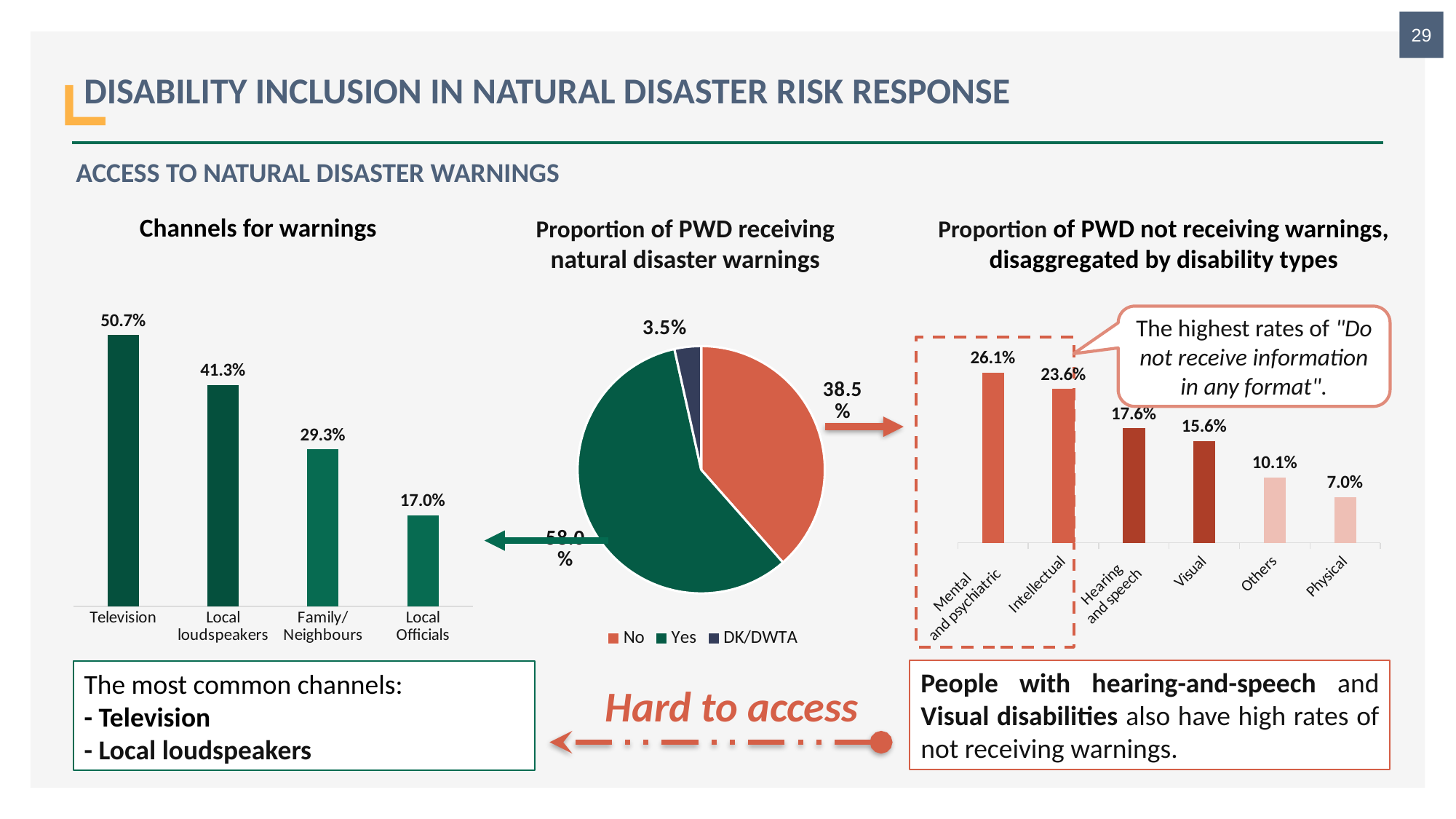
In the 'Proportion of PWD receiving natural disaster warnings' pie chart, what share is labelled 'No'? 38.5% In the 'Proportion of PWD not receiving warnings, disaggregated by disability types' chart, do the values rise or fall from left to right? Fall How many categories are shown in the 'Channels for warnings' chart? 4 In the 'Channels for warnings' chart, what is the value for Television? 50.7% In the 'Channels for warnings' chart, what is the difference between Television and Local loudspeakers? 9.4% In the 'Proportion of PWD not receiving warnings, disaggregated by disability types' chart, what is the value for Physical? 7.0% In the 'Channels for warnings' chart, which channel has the lowest value? Local Officials In the 'Proportion of PWD not receiving warnings, disaggregated by disability types' chart, which disability type has the highest value? Mental and psychiatric How many entries does the legend of the 'Proportion of PWD receiving natural disaster warnings' pie chart list? 3 In the 'Proportion of PWD not receiving warnings, disaggregated by disability types' chart, which is larger: Hearing and speech or Visual? Hearing and speech What kind of chart is 'Proportion of PWD receiving natural disaster warnings'? Pie chart In the 'Proportion of PWD receiving natural disaster warnings' pie chart, what share is labelled 'DK/DWTA'? 3.5%